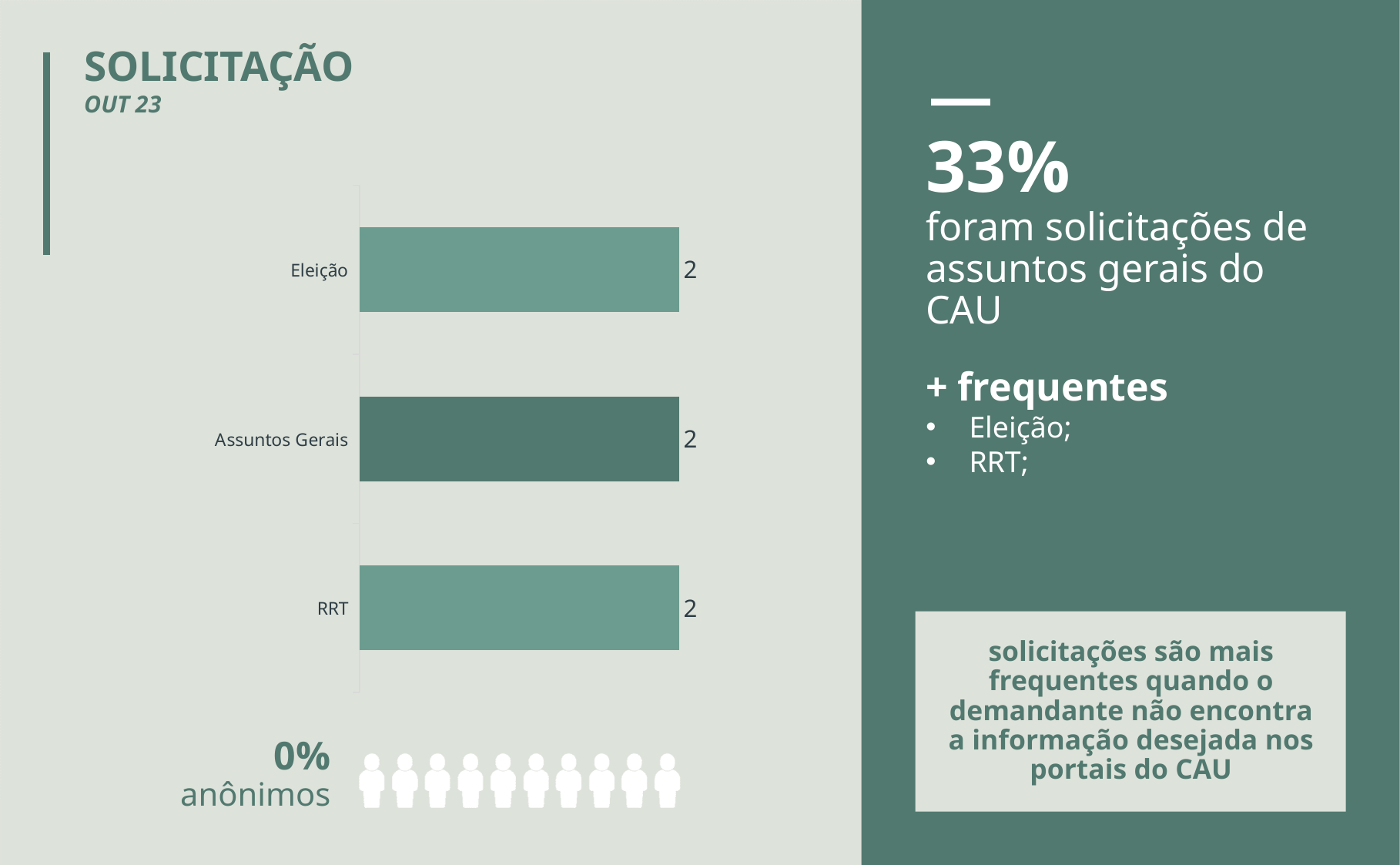
What is the value for RRT in the bar chart? 2 Do the three bars in the chart have the same value or different values? the same value What is the difference between the values for Eleição and RRT? 0 What kind of chart is shown on the slide? bar chart Which category's bar is drawn in a darker green than the other two? Assuntos Gerais What is the value for Assuntos Gerais in the bar chart? 2 How many categories are shown in the bar chart? 3 Which category is listed at the top of the bar chart? Eleição What is the value for Eleição in the bar chart? 2 What is the combined total of the three bars in the chart? 6